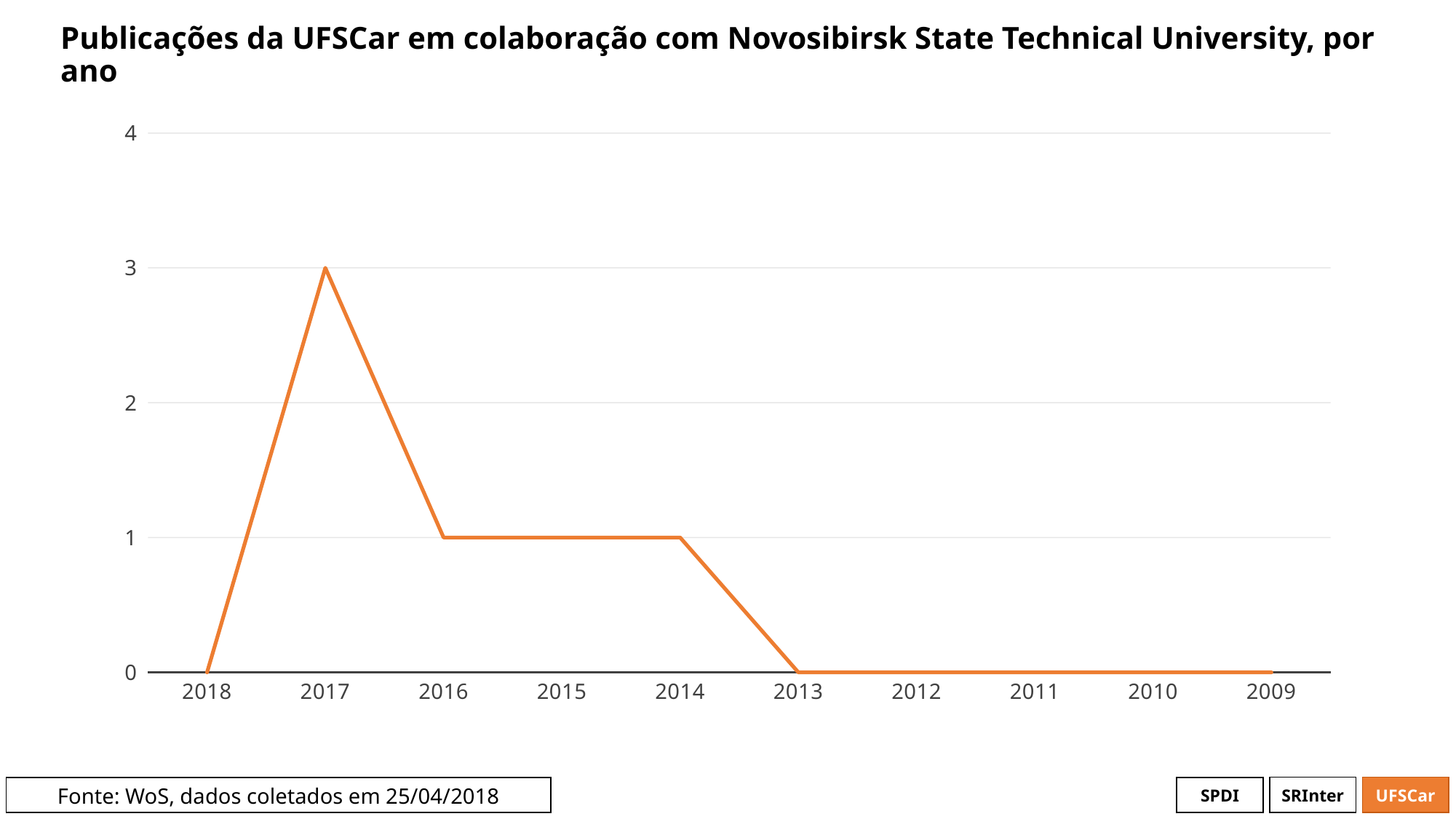
Which year has the highest number of publications? 2017 Which is larger, the value for 2017 or the value for 2015? 2017 What is the title of the chart? Publicações da UFSCar em colaboração com Novosibirsk State Technical University, por ano What is the difference between the values for 2017 and 2016? 2 What is the value for 2016? 1 What is the value for 2018? 0 What is the value for 2014? 1 How many years are shown on the x axis? 10 Do the values rise or fall from 2017 to 2013 along the x axis? fall What kind of chart is shown on the slide? line chart Is the value for 2017 greater or less than 2? greater What is the value for 2017? 3